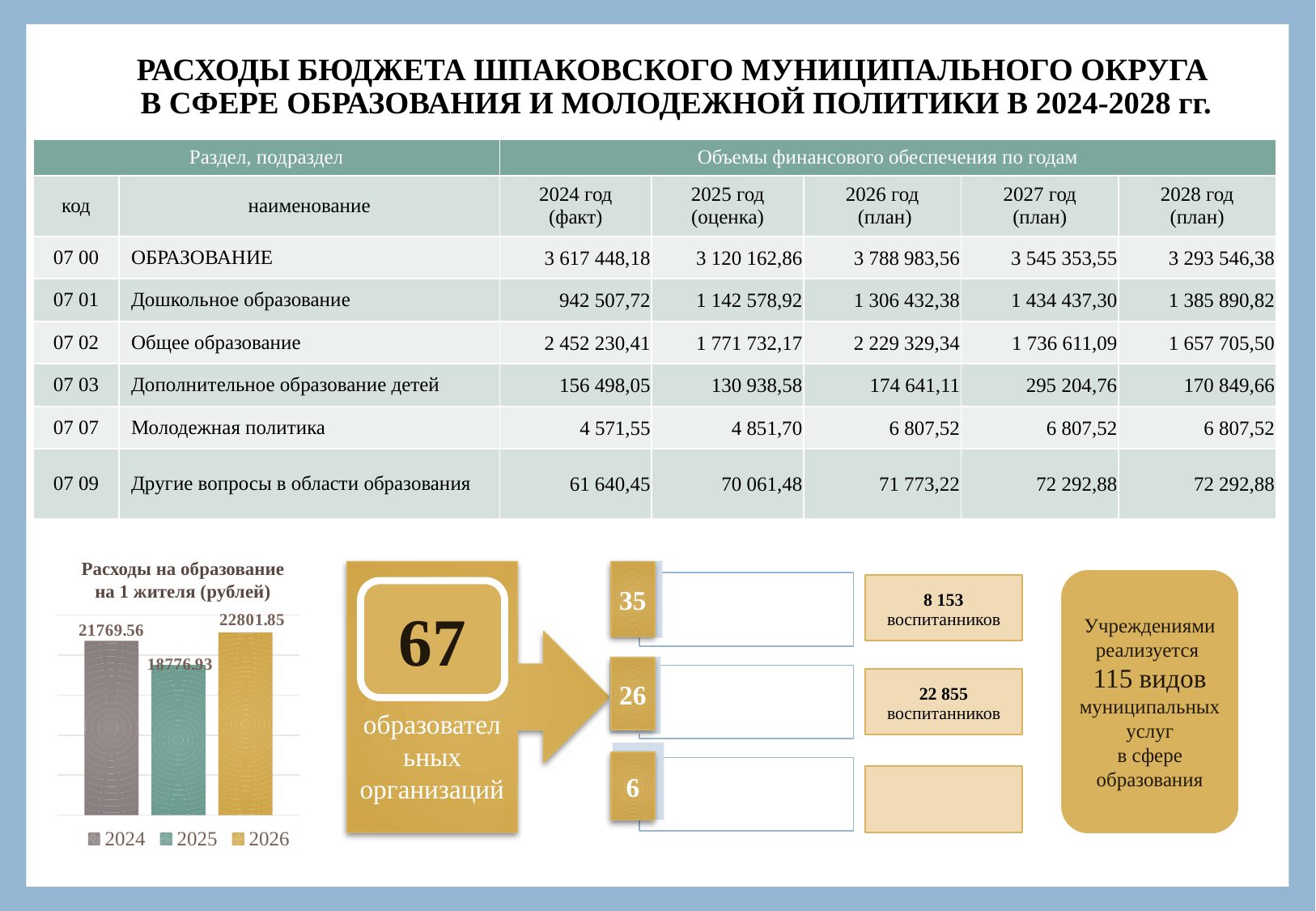
In the chart "Расходы на образование на 1 жителя (рублей)", which year has the highest value? 2026 In the chart "Расходы на образование на 1 жителя (рублей)", what is the value for 2026? 22801.85 In the chart "Расходы на образование на 1 жителя (рублей)", what is the value for 2024? 21769.56 How many entries does the legend of the chart "Расходы на образование на 1 жителя (рублей)" list? 3 In the chart "Расходы на образование на 1 жителя (рублей)", which year has the lowest value? 2025 In the chart "Расходы на образование на 1 жителя (рублей)", what is the difference between the 2024 and 2025 values? 2992.63 In the chart "Расходы на образование на 1 жителя (рублей)", what colour is the bar for 2025? green In the chart "Расходы на образование на 1 жителя (рублей)", which is larger, the value for 2024 or the value for 2025? 2024 How many bars are plotted in the chart "Расходы на образование на 1 жителя (рублей)"? 3 In the chart "Расходы на образование на 1 жителя (рублей)", what is the value for 2025? 18776.93 In the chart "Расходы на образование на 1 жителя (рублей)", what is the difference between the 2026 and 2024 values? 1032.29 What kind of chart is "Расходы на образование на 1 жителя (рублей)"? bar chart